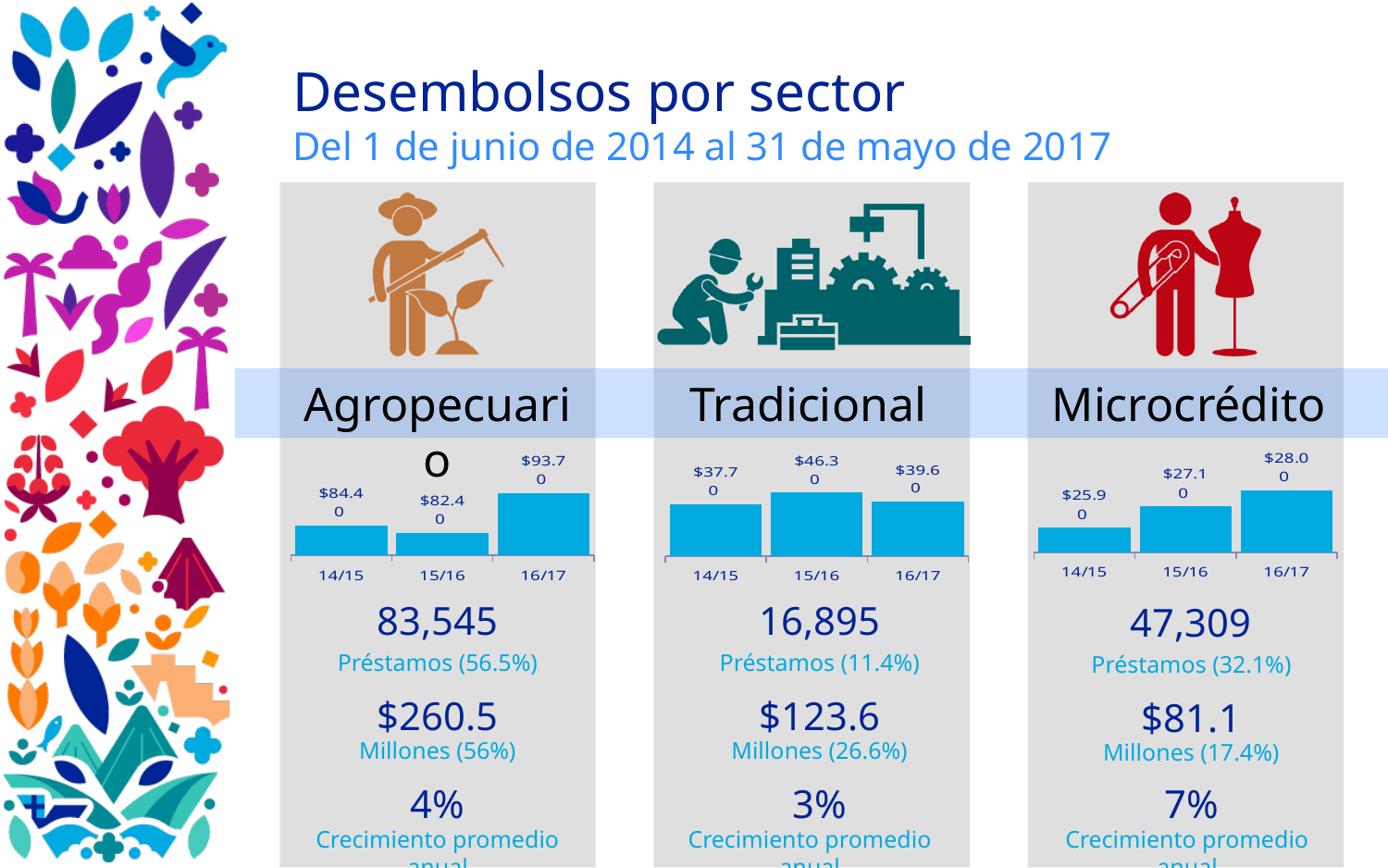
In the Agropecuario chart, which period has the lowest value? 15/16 In the Tradicional chart, which period has the highest value? 15/16 In the Agropecuario chart, what is the difference between the 16/17 and 15/16 values? $11.30 In the Tradicional chart, which is larger, the value for 14/15 or the value for 16/17? 16/17 What is the title of the slide containing the three charts? Desembolsos por sector In the Microcrédito chart, do the values rise or fall from 14/15 to 16/17? Rise In the Microcrédito chart, which period has the highest value? 16/17 How many periods are shown in the Microcrédito chart? 3 In the Microcrédito chart, what is the value for 14/15? $25.90 What kind of chart is used for the Tradicional sector? Bar chart In the Tradicional chart, what is the value for 15/16? $46.30 In the Agropecuario chart, what is the value for 16/17? $93.70